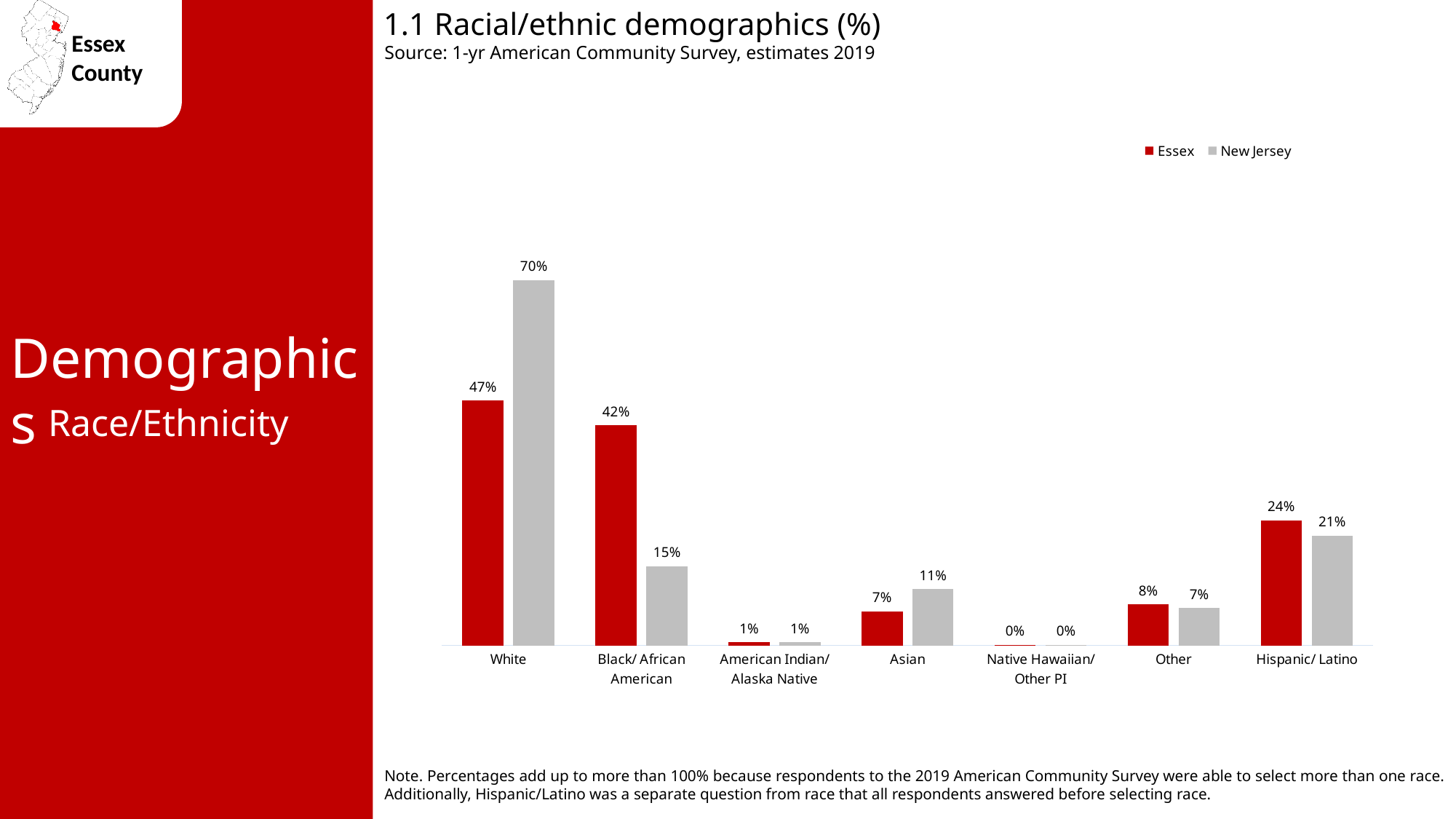
How many series does the legend list? 2 Which category has the highest New Jersey value? White What is the Essex value for Hispanic/ Latino? 24% What is the difference between the New Jersey and Essex values for White? 23% What is the New Jersey value for Black/ African American? 15% Which category has the highest Essex value? White What is the difference between the Essex and New Jersey values for Black/ African American? 27% Which is larger for Asian, the Essex value or the New Jersey value? New Jersey What is the New Jersey value for Asian? 11% What kind of chart is shown on the slide? Bar chart How many categories are shown on the x axis? 7 What is the Essex value for White? 47%